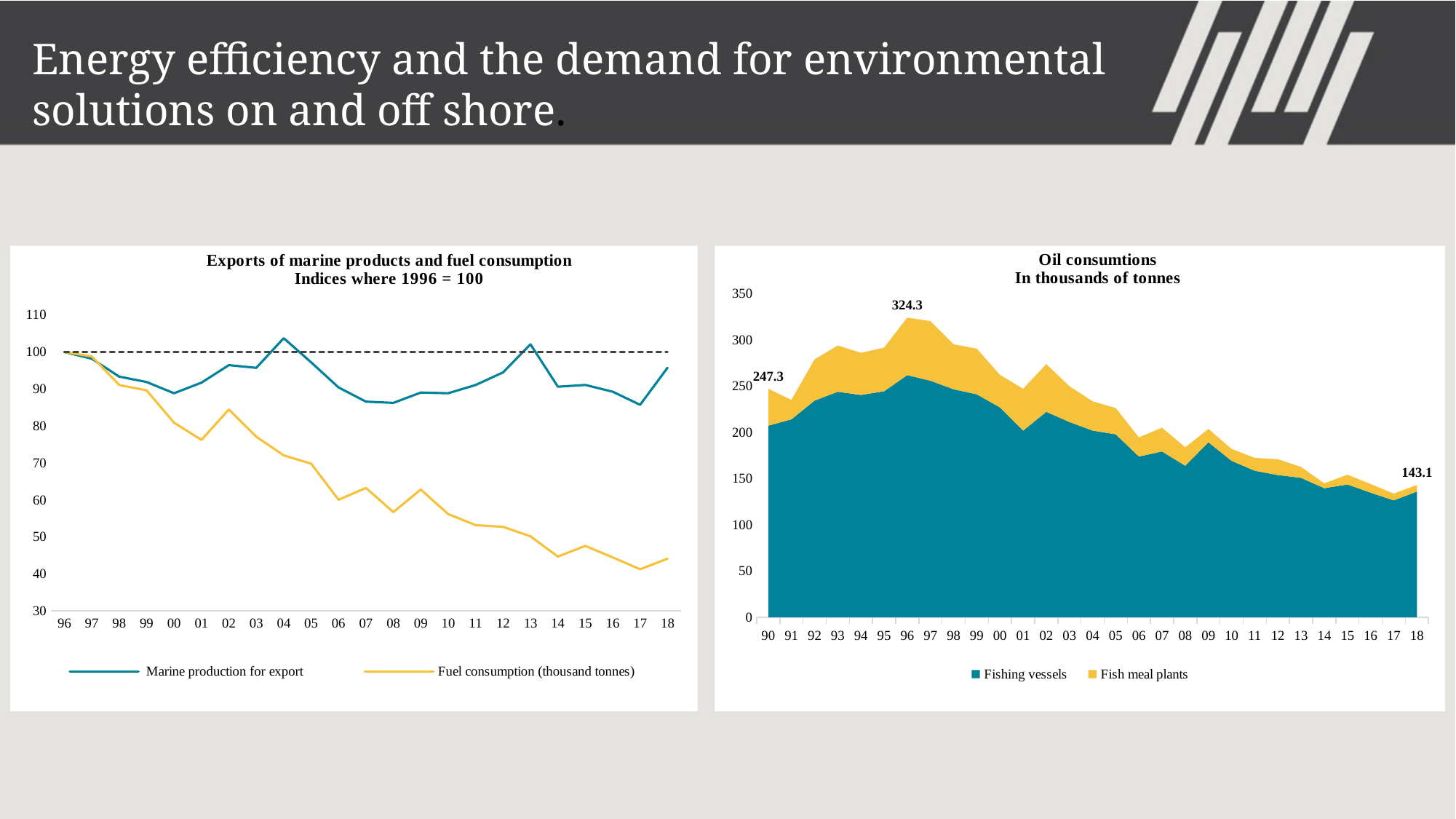
What kind of chart is the 'Oil consumtions' chart on the right? Stacked area chart In the 'Exports of marine products and fuel consumption' chart, is the fuel consumption index for 2018 greater or less than 50? less In the 'Oil consumtions' chart, which series forms the larger part of the stacked area? Fishing vessels In the 'Oil consumtions' chart, what is the total oil consumption labelled for 1990? 247.3 In the 'Oil consumtions' chart, do total oil consumption values rise or fall from 1996 to 2018? Fall In the 'Exports of marine products and fuel consumption' chart, does the fuel consumption index rise or fall from 1996 to 2018? Fall In the 'Oil consumtions' chart, what is the total oil consumption labelled for 1996? 324.3 In the 'Oil consumtions' chart, how many series does the legend list? 2 In the 'Exports of marine products and fuel consumption' chart, how many series does the legend list? 2 In the 'Oil consumtions' chart, what is the difference between the labelled totals for 1996 and 2018? 181.2 In the 'Oil consumtions' chart, what is the total oil consumption labelled for 2018? 143.1 What kind of chart is the 'Exports of marine products and fuel consumption' chart on the left? Line chart